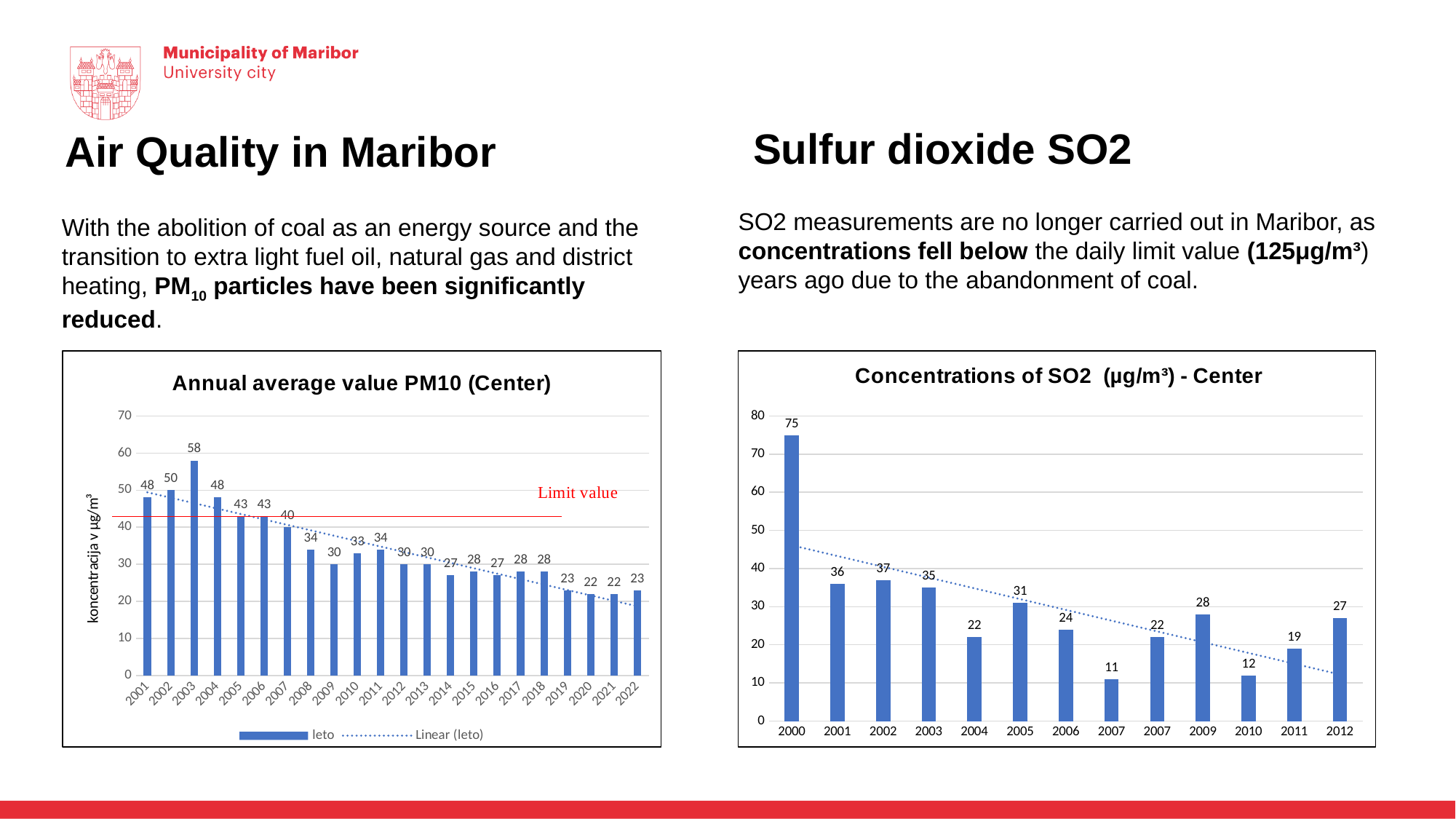
In the 'Concentrations of SO2 (µg/m³) - Center' chart, which is larger, the value for 2005 or the value for 2006? 2005 What kind of chart is the 'Concentrations of SO2 (µg/m³) - Center' chart? bar chart In the 'Concentrations of SO2 (µg/m³) - Center' chart, what is the value for 2011? 19 In the 'Concentrations of SO2 (µg/m³) - Center' chart, which year has the highest value? 2000 In the 'Annual average value PM10 (Center)' chart, what is the value for 2003? 58 In the 'Annual average value PM10 (Center)' chart, what is the difference between the values for 2001 and 2022? 25 In the 'Concentrations of SO2 (µg/m³) - Center' chart, what is the difference between the values for 2000 and 2001? 39 In the 'Annual average value PM10 (Center)' chart, how many years are plotted? 22 In the 'Annual average value PM10 (Center)' chart, do the values generally rise or fall from 2001 to 2022? fall In the 'Concentrations of SO2 (µg/m³) - Center' chart, what is the value for 2000? 75 In the 'Annual average value PM10 (Center)' chart, how many entries does the legend list? 2 In the 'Annual average value PM10 (Center)' chart, which year has the highest value? 2003